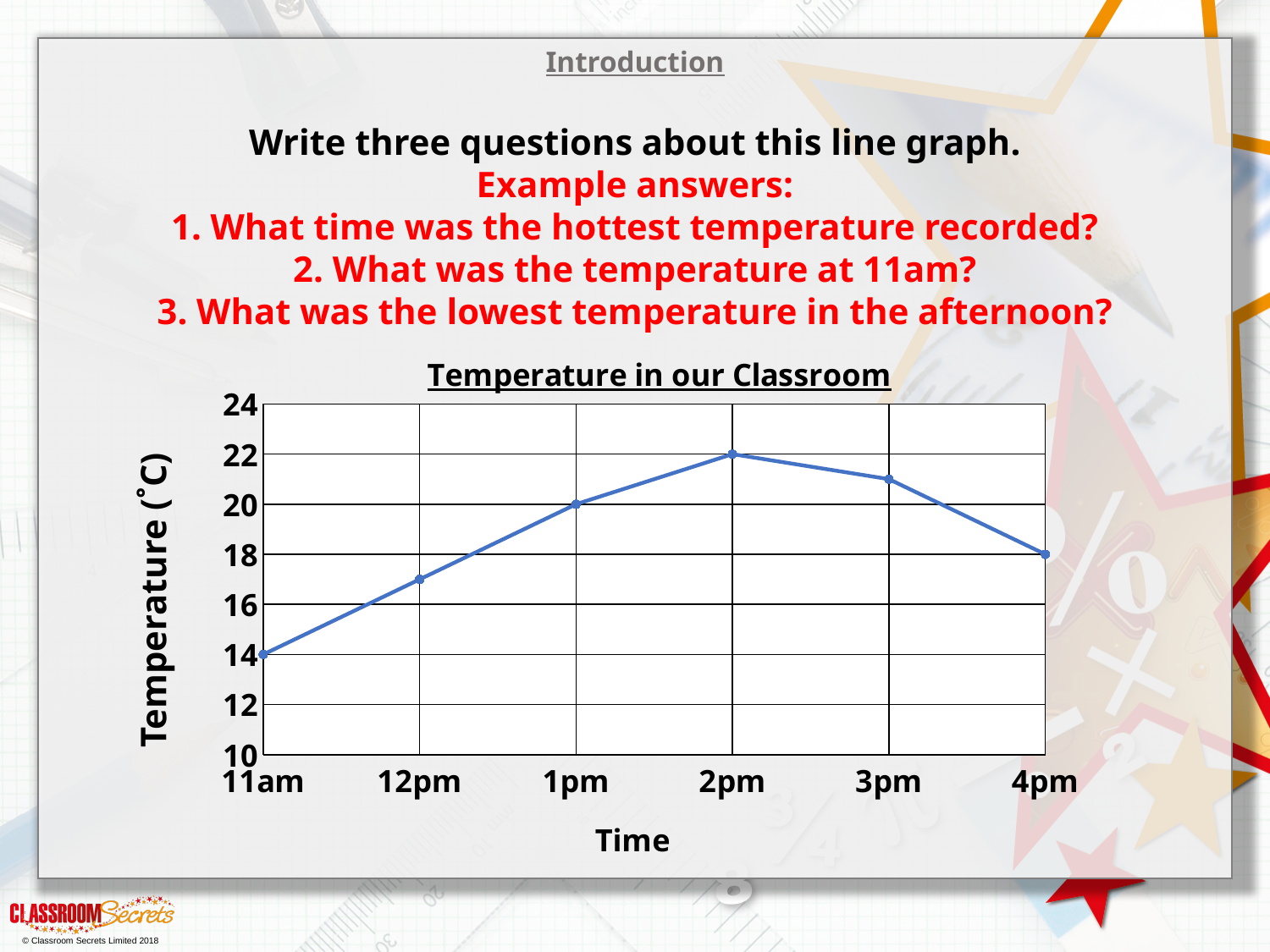
What type of chart is shown on the slide? line chart What was the temperature at 1pm? 20 What was the temperature at 4pm? 18 Is the temperature at 3pm greater or less than 22? less What was the temperature at 2pm? 22 At what time was the highest temperature recorded? 2pm At what time was the lowest temperature recorded? 11am Is the temperature at 12pm greater or less than 16? greater What is the title of the chart? Temperature in our Classroom What was the temperature at 11am? 14 What is the difference between the temperature at 2pm and the temperature at 11am? 8 How many time points are plotted on the chart? 6